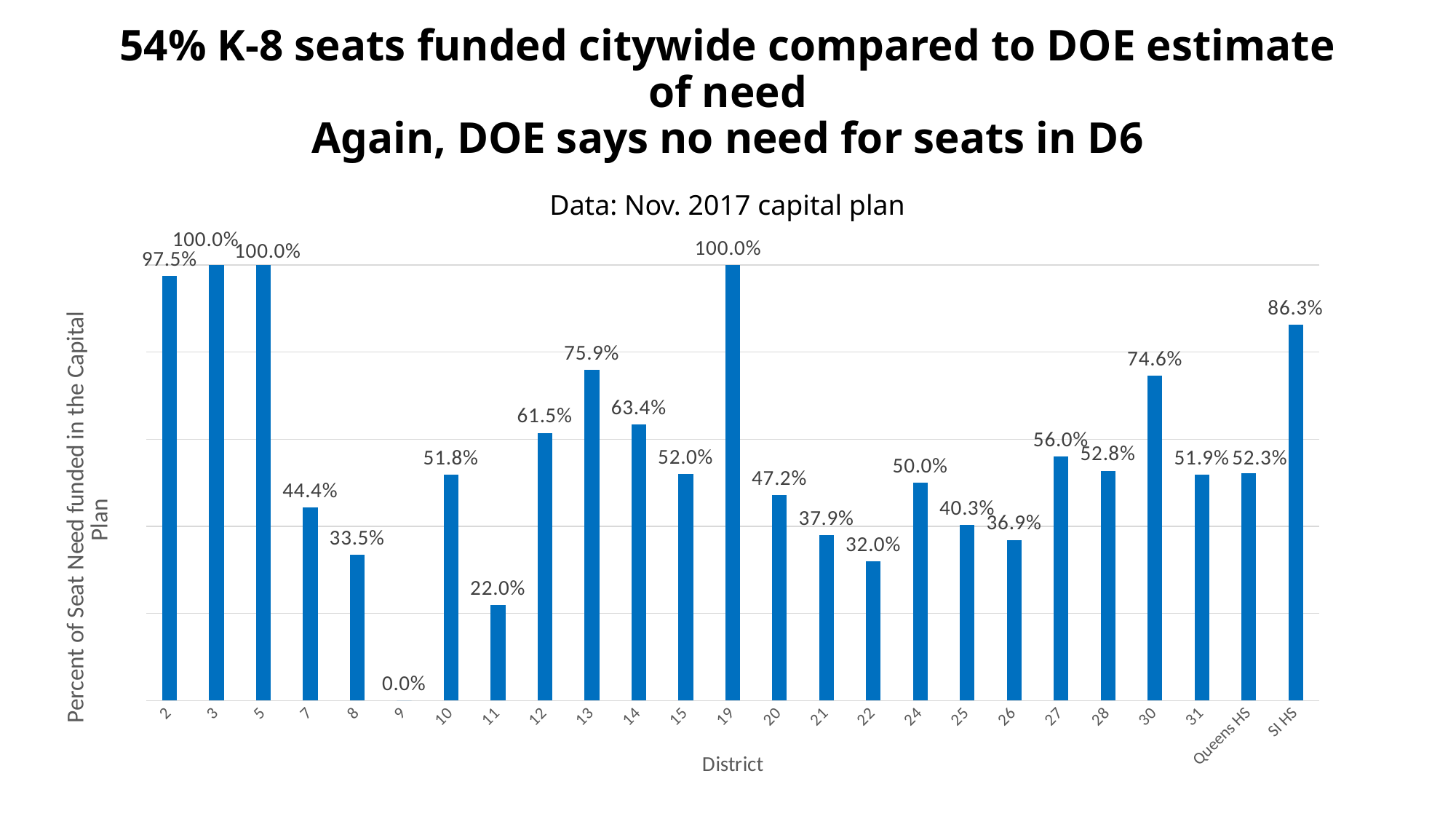
Which districts have the highest value of 100.0%? 3, 5 and 19 Which district has the lowest value? 9 Which is larger, the value for district 12 or the value for district 14? district 14 What data source is cited below the title? Nov. 2017 capital plan What is the value for district 11? 22.0% What is the difference between the values for district 30 and district 7? 30.2% What is the value for SI HS? 86.3% What kind of chart is this? bar chart What is the value for Queens HS? 52.3% How many districts are shown on the x axis? 25 What is the value for district 13? 75.9% What is the label of the y axis? Percent of Seat Need funded in the Capital Plan